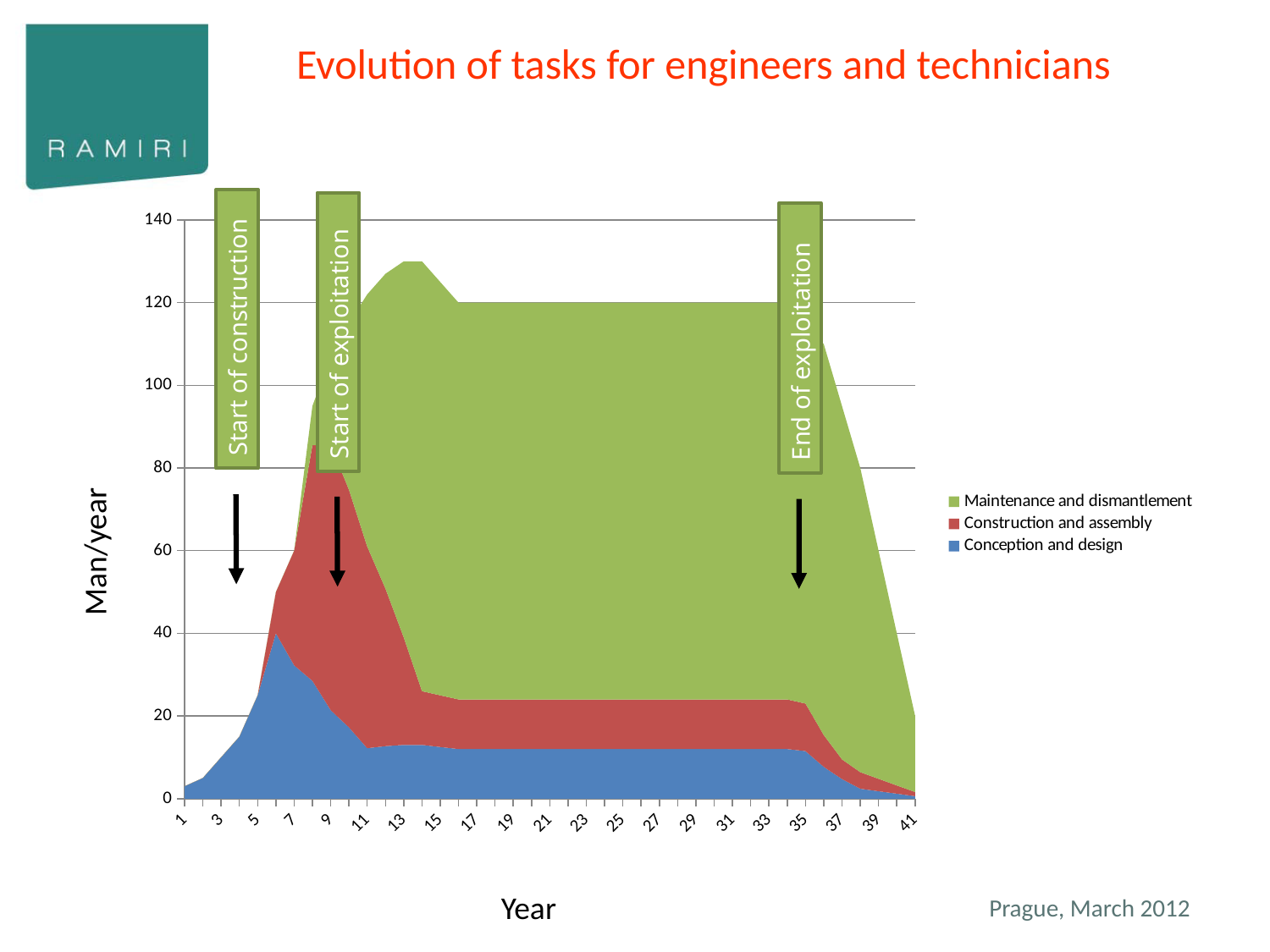
How many series does the legend list? 3 How does the total Man/year value change between year 35 and year 41? It falls Is the total Man/year value larger at year 13 or at year 41? Year 13 What is the title of the chart? Evolution of tasks for engineers and technicians Is the total Man/year value at year 41 greater or less than 40? less What kind of chart is shown on the slide? Stacked area chart Which series accounts for the largest share of the total at year 21? Maintenance and dismantlement Is the total Man/year value at year 21 greater or less than 100? greater What are the three annotation labels marked on the chart? Start of construction, Start of exploitation, End of exploitation Is the total Man/year value at year 1 greater or less than 20? less What is the last year label shown on the x axis? 41